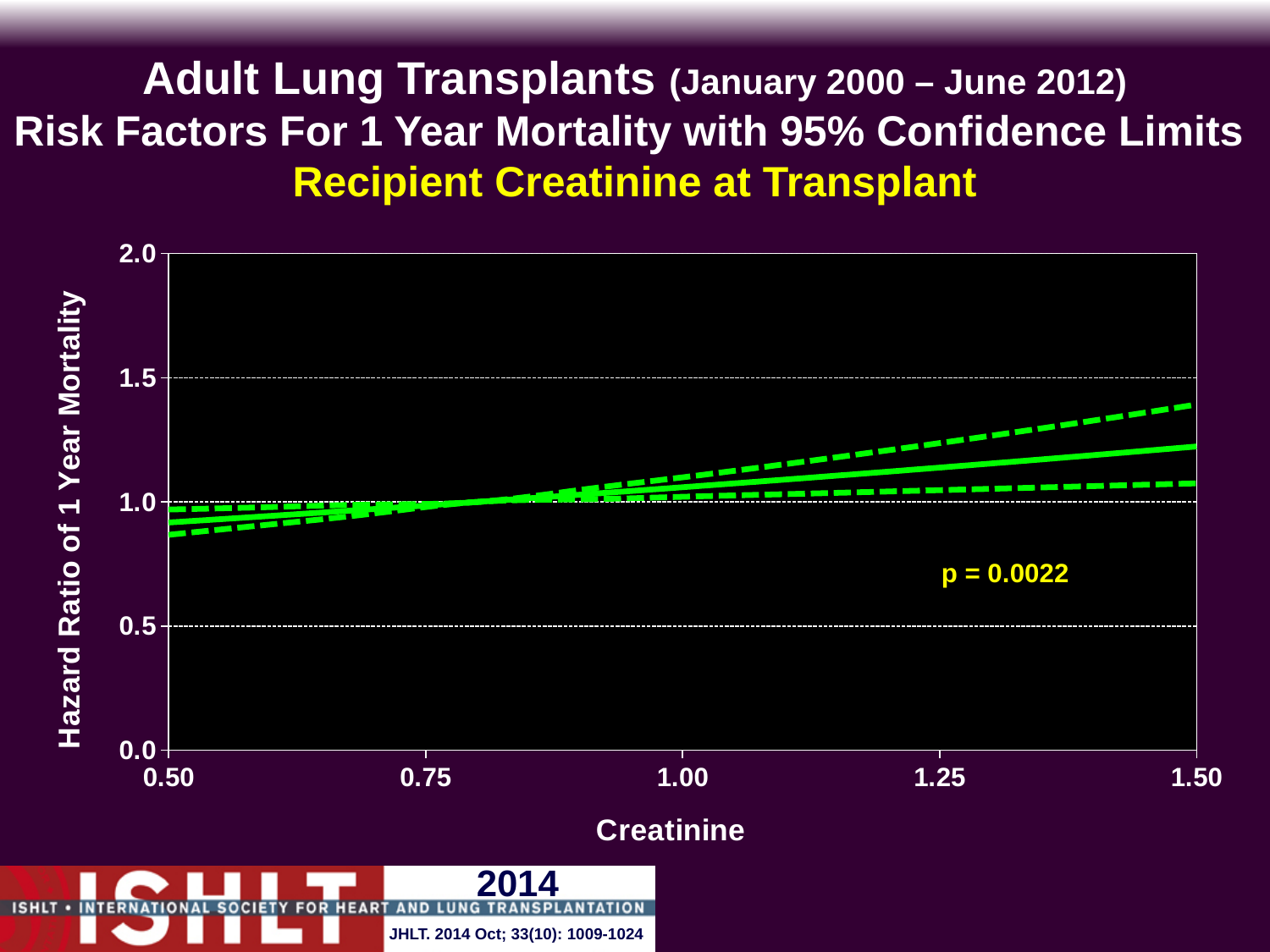
Is the upper confidence limit at a creatinine of 1.50 greater or less than 1.5? less What is the label of the x axis? Creatinine What kind of chart is shown on the slide? line chart How many lines are plotted on the chart? 3 Is the hazard ratio for the solid line at a creatinine of 1.50 greater or less than 1.0? greater Is the lower confidence limit at a creatinine of 1.50 greater or less than 1.0? greater What p-value is printed on the chart? p = 0.0022 What is the lowest creatinine value shown on the x axis? 0.50 What is the highest value shown on the y axis? 2.0 Does the hazard ratio of 1 year mortality rise or fall as creatinine increases from 0.50 to 1.50? rise